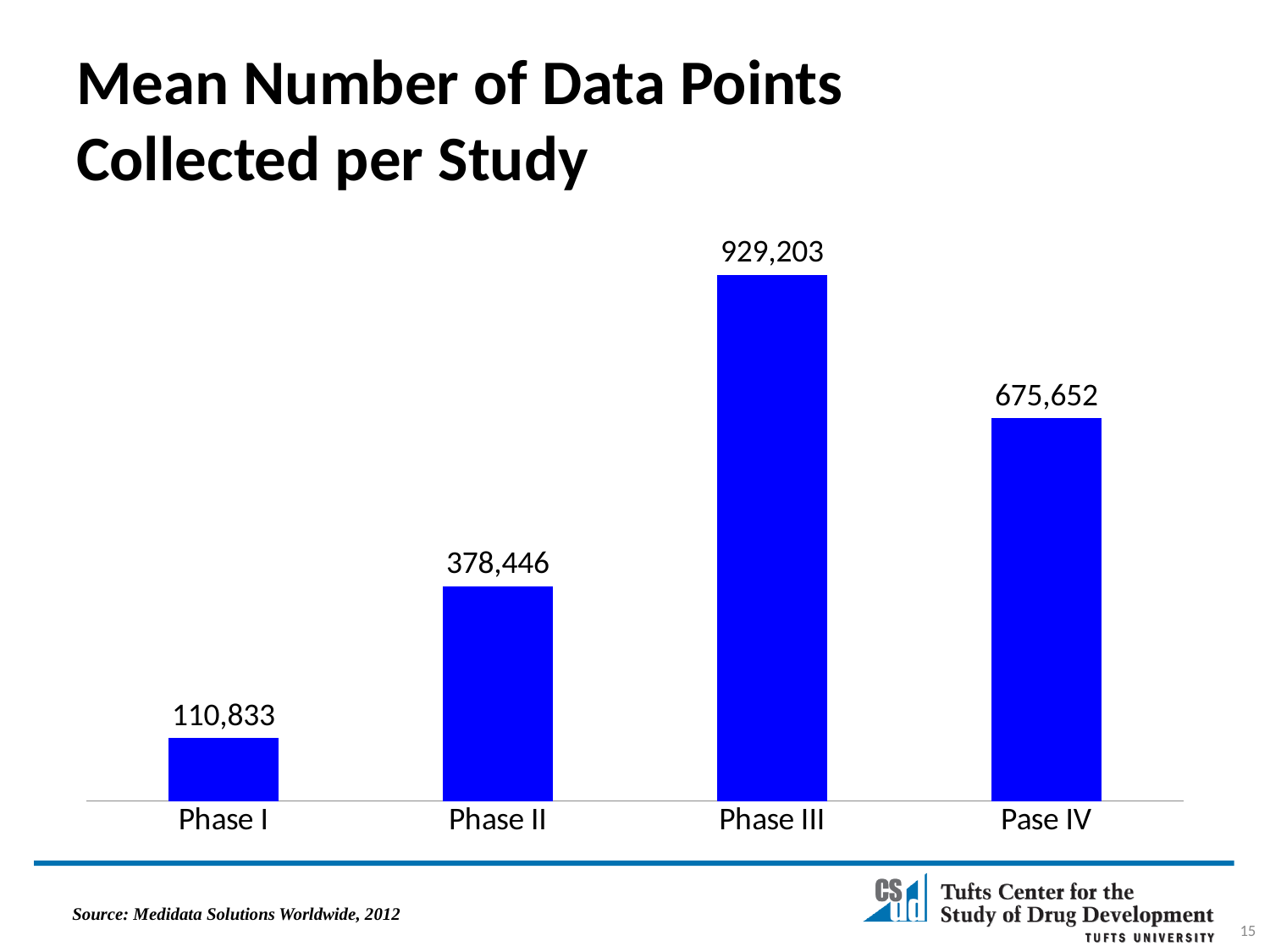
Which phase has the highest mean number of data points collected per study? Phase III What is the value shown for the bar labelled Pase IV? 675,652 What is the value shown for Phase III? 929,203 What is the value shown for Phase II? 378,446 What is the difference between the values for Phase III and Pase IV? 253,551 What is the difference between the values for Phase II and Phase I? 267,613 Which is larger, the value for Phase II or the value for Pase IV? Pase IV What kind of chart is shown on the slide? Bar chart Do the values rise or fall from Phase I to Phase III? Rise How many phases are shown on the chart? 4 Which phase has the lowest mean number of data points collected per study? Phase I What is the mean number of data points collected per study for Phase I? 110,833